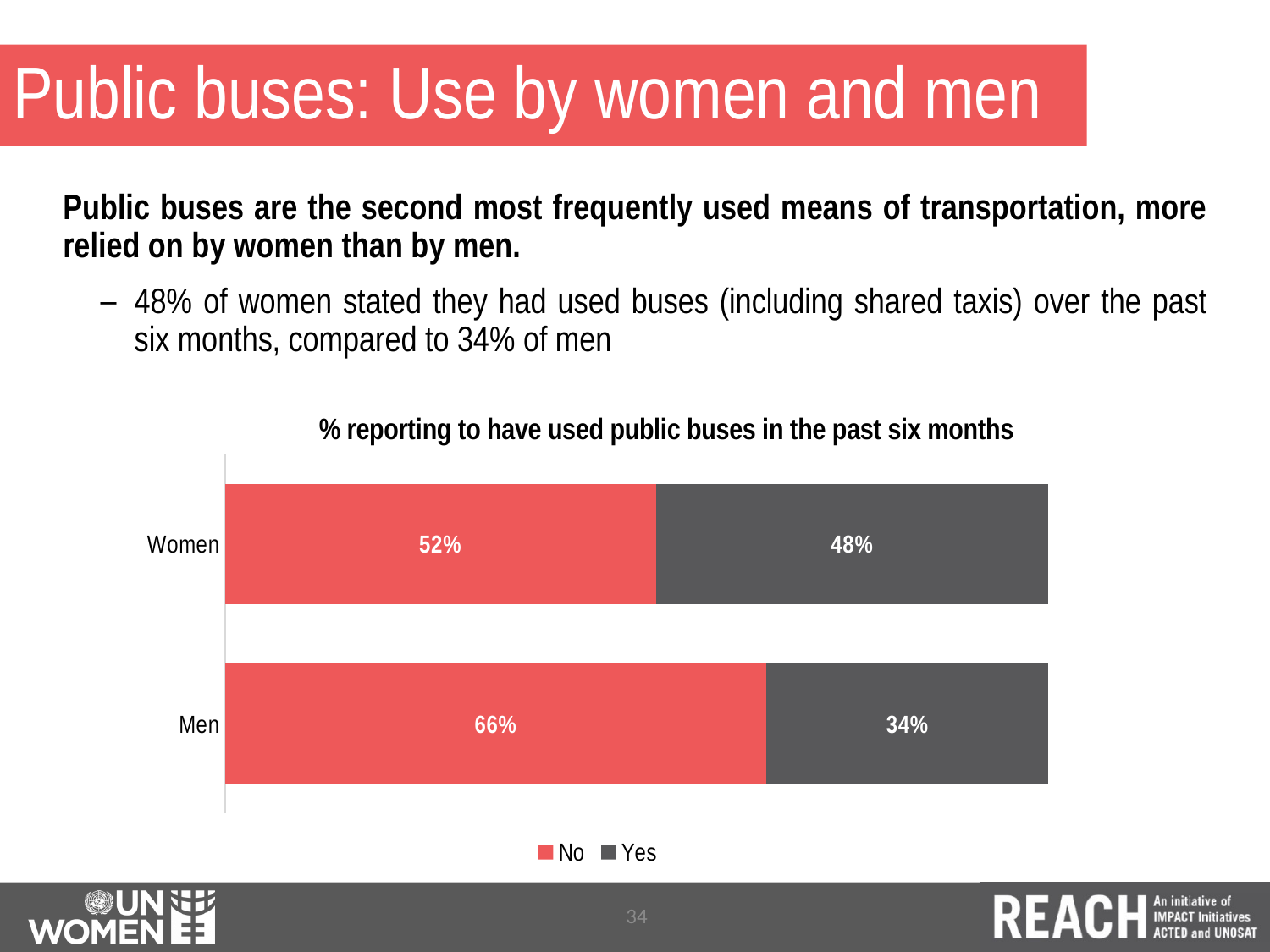
What is the total of the Women bar (No plus Yes)? 100% Which group has the higher "Yes" share, Women or Men? Women Which group has the highest "No" value? Men What is the "No" value for Men in the chart? 66% How many categories (groups) are shown on the chart? 2 What percentage of women reported having used public buses in the past six months (the "Yes" value)? 48% What is the difference between the "Yes" values for Women and Men? 14 percentage points What is the title of the chart? % reporting to have used public buses in the past six months What is the "No" value for Women? 52% What is the "Yes" value for Men? 34% How many series does the legend list? 2 What type of chart is shown on the slide? Stacked bar chart